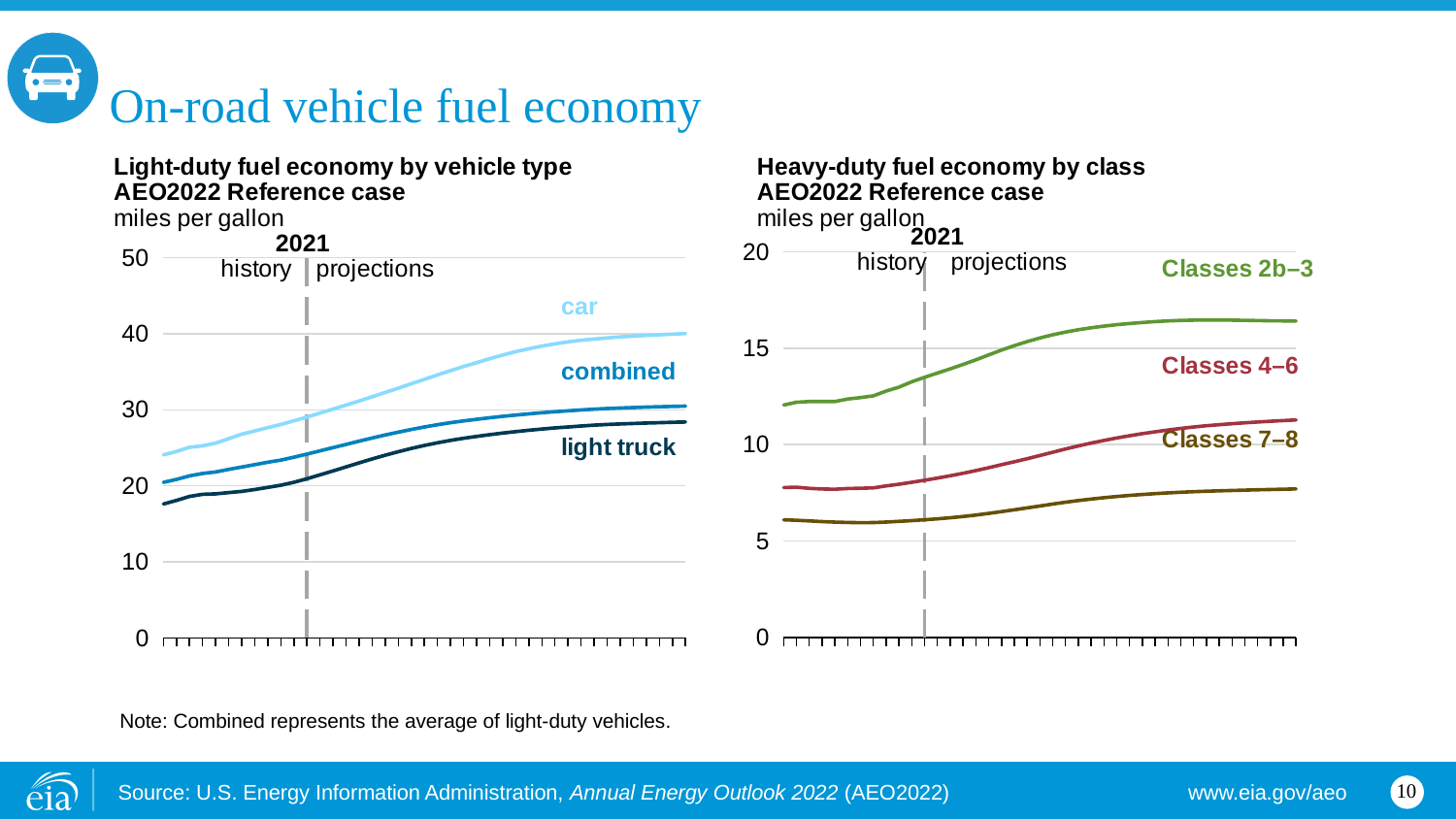
What type of chart is the 'Light-duty fuel economy by vehicle type' chart? line chart In the 'Light-duty fuel economy by vehicle type' chart, which is higher at the end of the projections, car or light truck? car How many series are plotted in the 'Heavy-duty fuel economy by class' chart? 3 In the 'Heavy-duty fuel economy by class' chart, which class has the highest fuel economy? Classes 2b–3 In the 'Light-duty fuel economy by vehicle type' chart, which series has the lowest fuel economy throughout? light truck In the 'Heavy-duty fuel economy by class' chart, which class has the lowest fuel economy? Classes 7–8 In the 'Light-duty fuel economy by vehicle type' chart, is the value for car at the end of the projections greater or less than 30? greater In the 'Heavy-duty fuel economy by class' chart, is the value for Classes 7–8 at the end of the projections greater or less than 10? less What unit is used on the y axis of both charts? miles per gallon In the 'Light-duty fuel economy by vehicle type' chart, which series has the highest fuel economy at the end of the projection period? car In the 'Light-duty fuel economy by vehicle type' chart, does the car series rise or fall over the projection period? rise In the 'Heavy-duty fuel economy by class' chart, does the Classes 4–6 series rise or fall over the projection period? rise